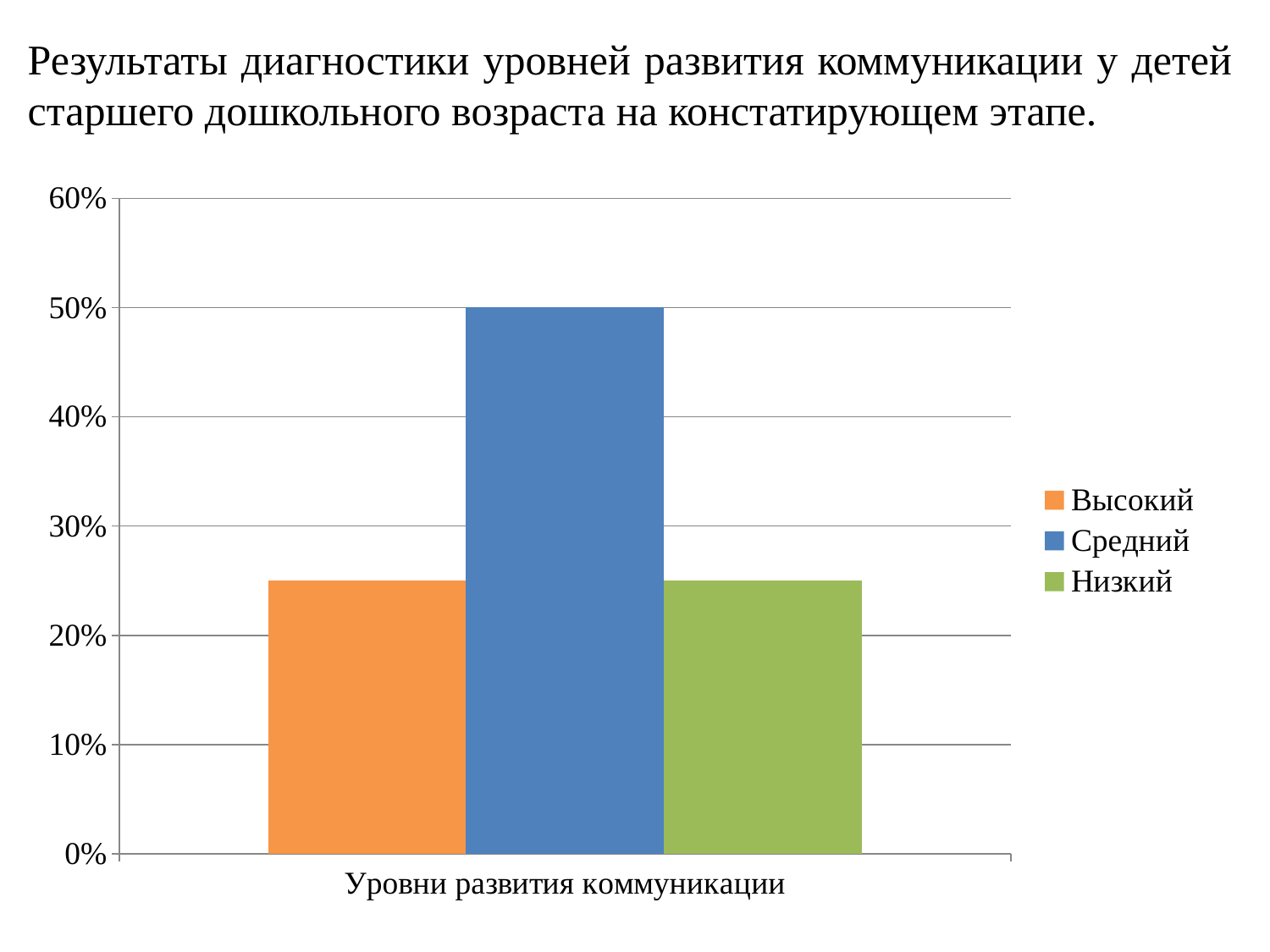
What is the value for Средний? 50% Which series has the highest value? Средний Is the value for Низкий greater or less than 20%? greater Is the value for Средний greater or less than 40%? greater How many categories are shown on the x axis? 1 Is the value for Высокий greater or less than 30%? less How many series does the legend list? 3 Which series is shown in blue? Средний Which is larger, the value for Средний or the value for Низкий? Средний What kind of chart is shown on the slide? bar chart Which is larger, the value for Средний or the value for Высокий? Средний What is the label of the category on the x axis? Уровни развития коммуникации